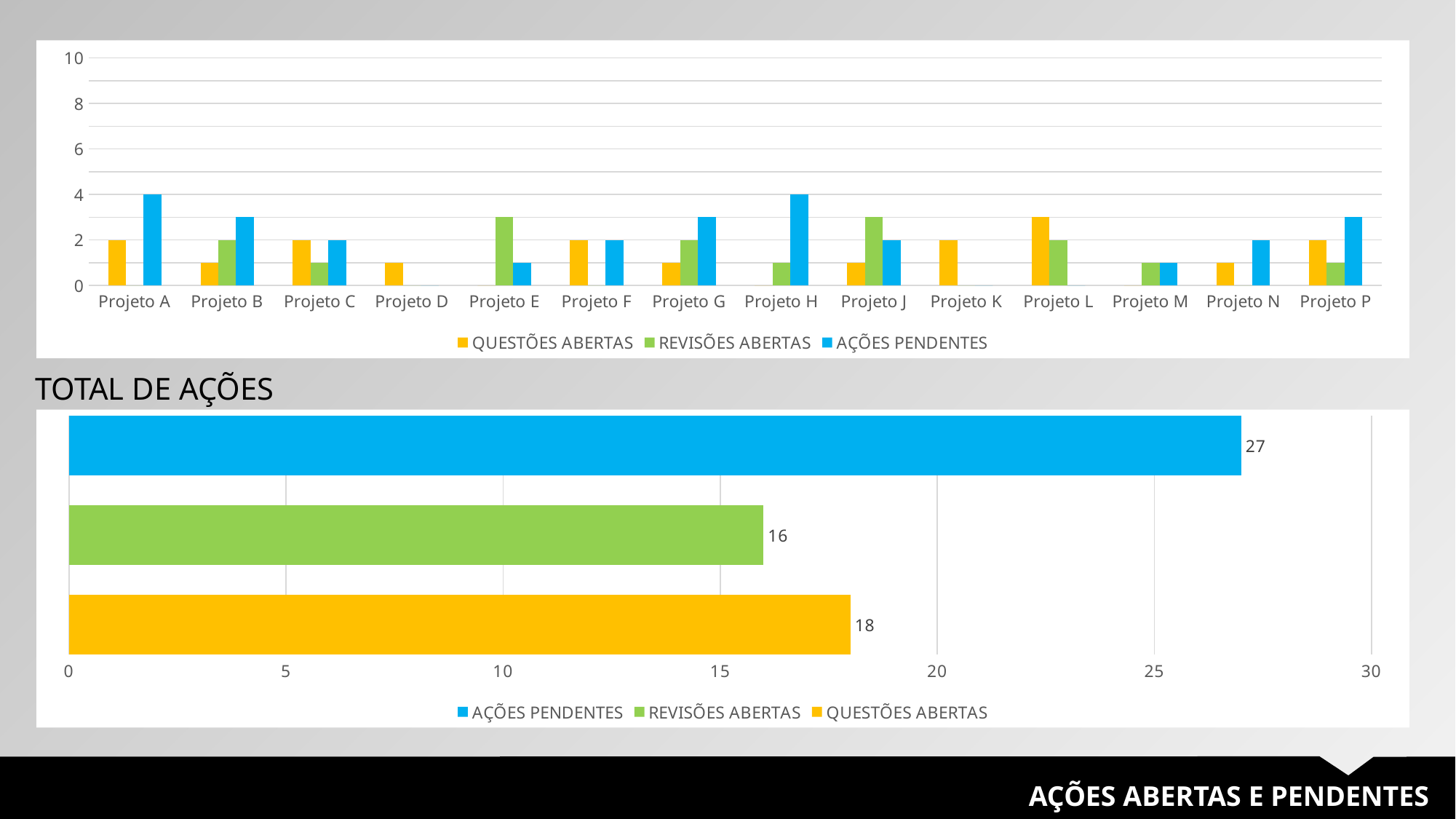
In the bottom chart titled TOTAL DE AÇÕES, what is the value for AÇÕES PENDENTES? 27 In the bottom chart titled TOTAL DE AÇÕES, what is the value for REVISÕES ABERTAS? 16 In the bottom chart titled TOTAL DE AÇÕES, what is the difference between AÇÕES PENDENTES and REVISÕES ABERTAS? 11 In the bottom chart titled TOTAL DE AÇÕES, which category has the highest value? AÇÕES PENDENTES In the top chart, how many projects are shown on the x axis? 14 In the top chart, how many series does the legend list? 3 In the top chart, what is the value of AÇÕES PENDENTES for Projeto A? 4 What kind of chart is the bottom chart titled TOTAL DE AÇÕES? Bar chart In the top chart, what is the value of AÇÕES PENDENTES for Projeto H? 4 In the bottom chart titled TOTAL DE AÇÕES, which category has the lowest value? REVISÕES ABERTAS In the bottom chart titled TOTAL DE AÇÕES, what is the value for QUESTÕES ABERTAS? 18 In the bottom chart titled TOTAL DE AÇÕES, which is larger, QUESTÕES ABERTAS or REVISÕES ABERTAS? QUESTÕES ABERTAS